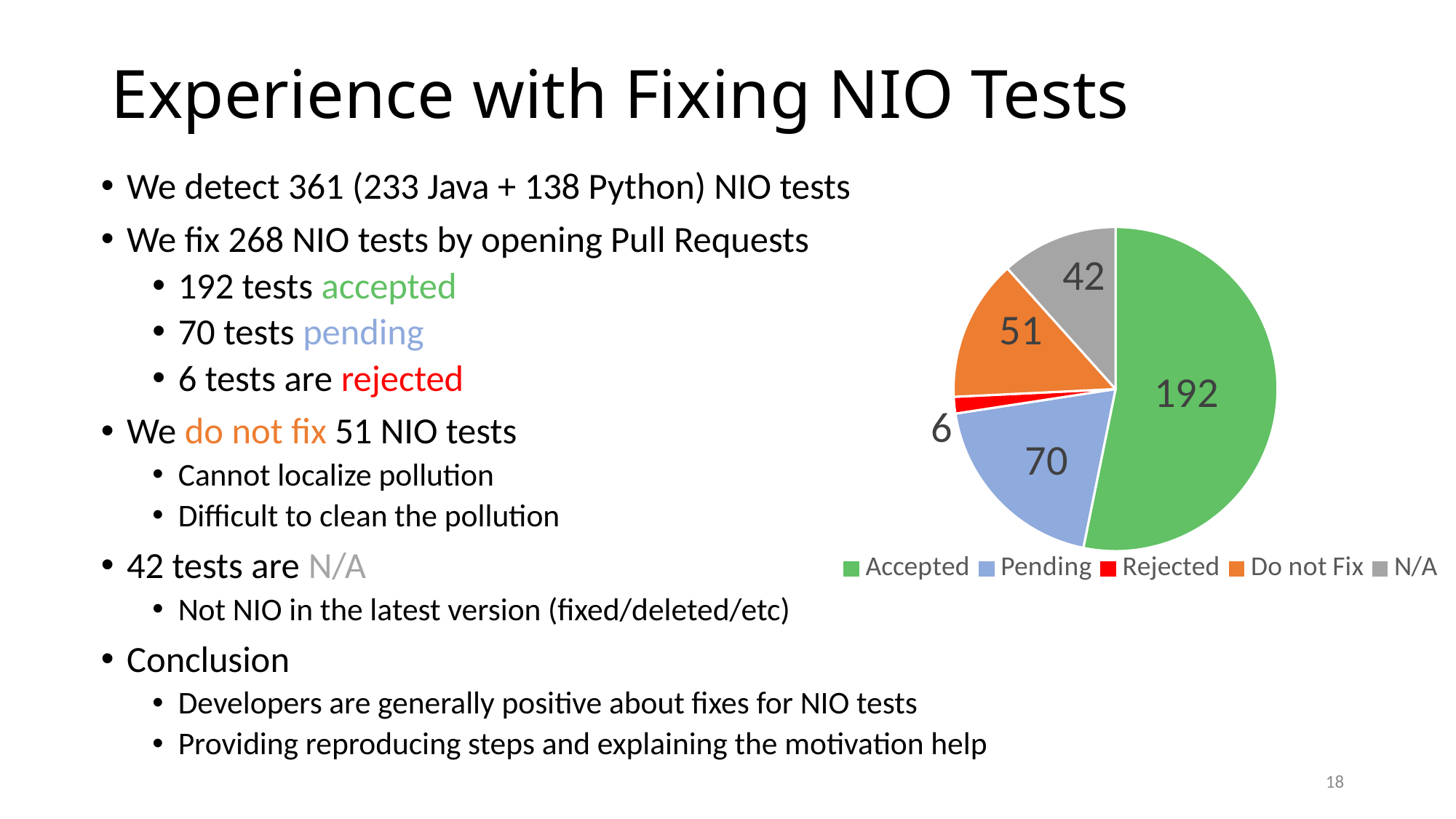
What is the value of the Pending slice in the pie chart? 70 What is the difference between the Accepted and Pending values in the pie chart? 122 Which category has the smallest slice in the pie chart? Rejected Which category has the largest slice in the pie chart? Accepted What is the value of the N/A slice in the pie chart? 42 What kind of chart is shown on the slide? pie chart What colour is the Rejected slice in the pie chart? red How many categories does the pie chart legend list? 5 What is the value of the Do not Fix slice in the pie chart? 51 How many tests are in the Accepted slice of the pie chart? 192 What is the value of the Rejected slice in the pie chart? 6 Which is larger in the pie chart, Do not Fix or N/A? Do not Fix